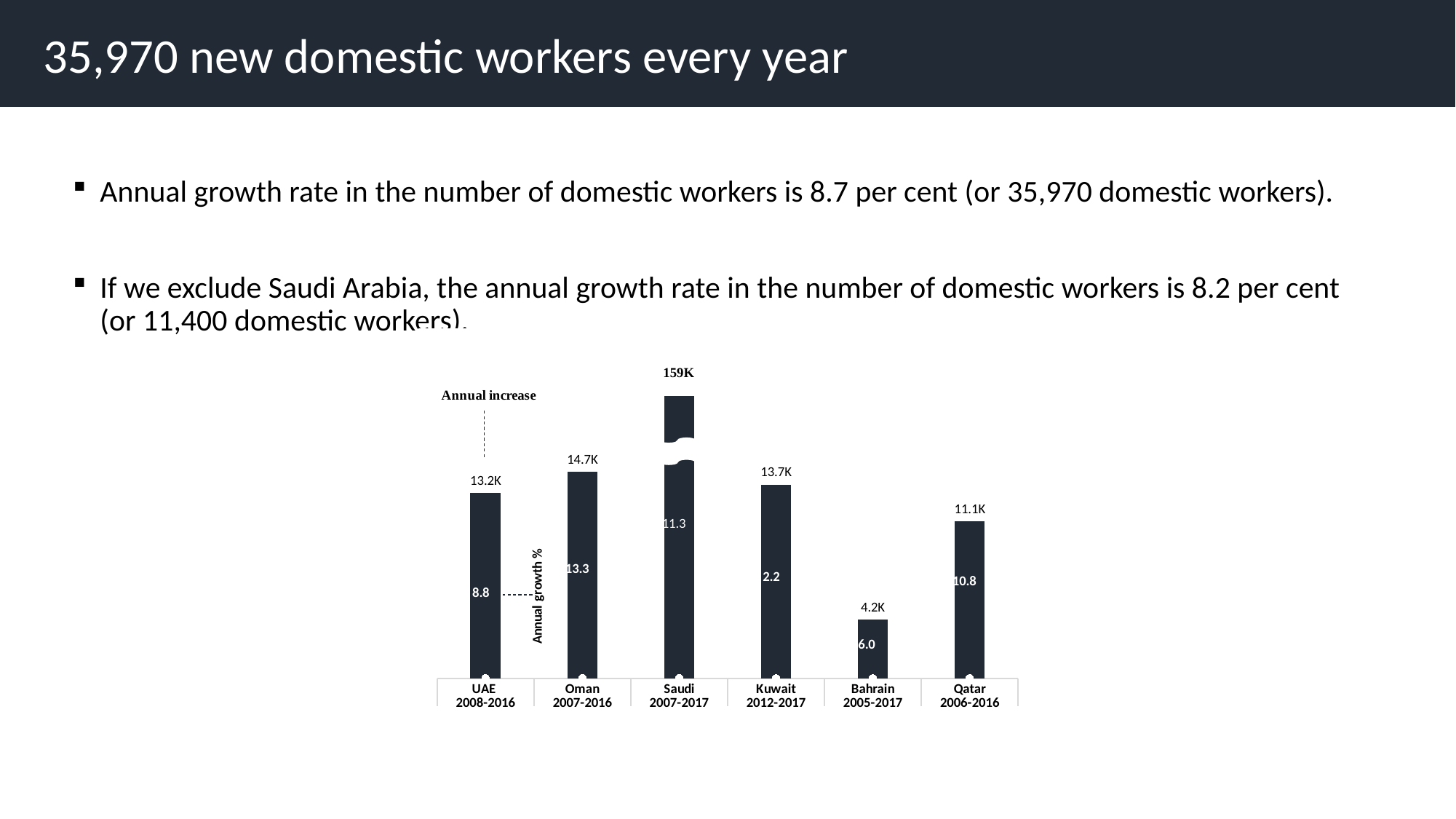
Which has a larger annual increase, Qatar or Bahrain? Qatar Which country has the highest annual increase in domestic workers? Saudi What annual growth % is shown inside the bar for Kuwait? 2.2 What is the annual increase in domestic workers shown for Oman? 14.7K What annual growth % is shown inside the bar for UAE? 8.8 Which country has the lowest annual increase in domestic workers? Bahrain How many countries are shown in the chart? 6 What type of chart is shown on the slide? Bar chart Which country has the highest annual growth % label? Oman What is the difference between the annual increase for Oman and for UAE? 1.5K What is the annual increase in domestic workers shown for Saudi? 159K Which country has the lowest annual growth % label? Kuwait